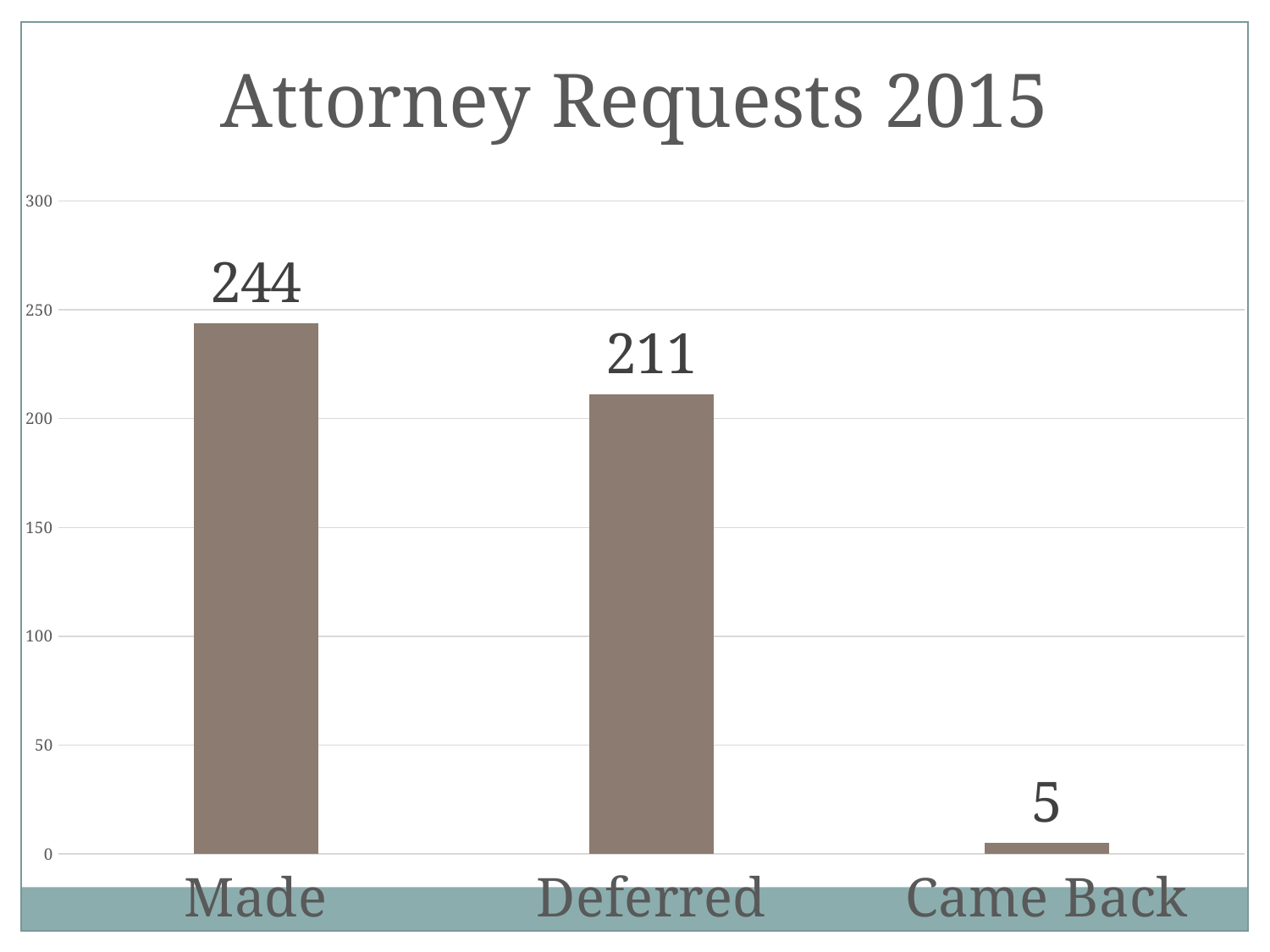
What is the difference between the values for Deferred and Came Back? 206 What is the value for Deferred? 211 How many categories are shown in the chart? 3 What is the value for Made? 244 What kind of chart is shown on the slide? bar chart What is the value for Came Back? 5 Which category has the lowest value? Came Back Which is larger, the value for Made or the value for Deferred? Made Which category has the highest value? Made What is the title of the chart? Attorney Requests 2015 Is the value for Deferred greater or less than 200? greater What is the difference between the values for Made and Deferred? 33